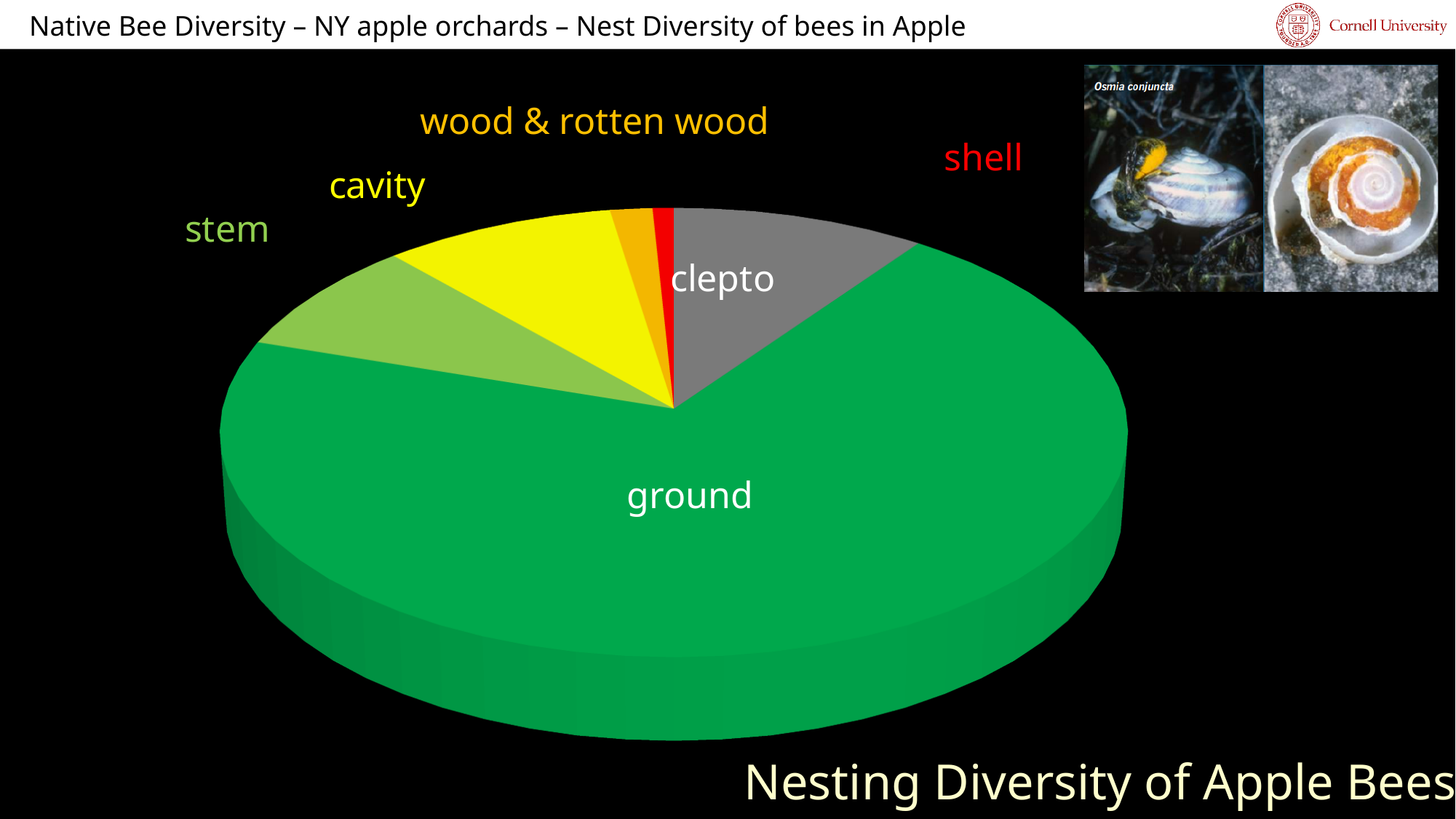
Which slice is larger, ground or stem? ground How many slices does the pie chart have? 6 Which slice is larger, stem or shell? stem What colour is the clepto slice of the pie chart? gray What is the title of the pie chart shown at the bottom of the slide? Nesting Diversity of Apple Bees Which slice is larger, cavity or shell? cavity Which nesting category has the largest slice of the pie? ground Which nesting category has the smallest slice of the pie? shell What kind of chart is shown on the slide? pie chart